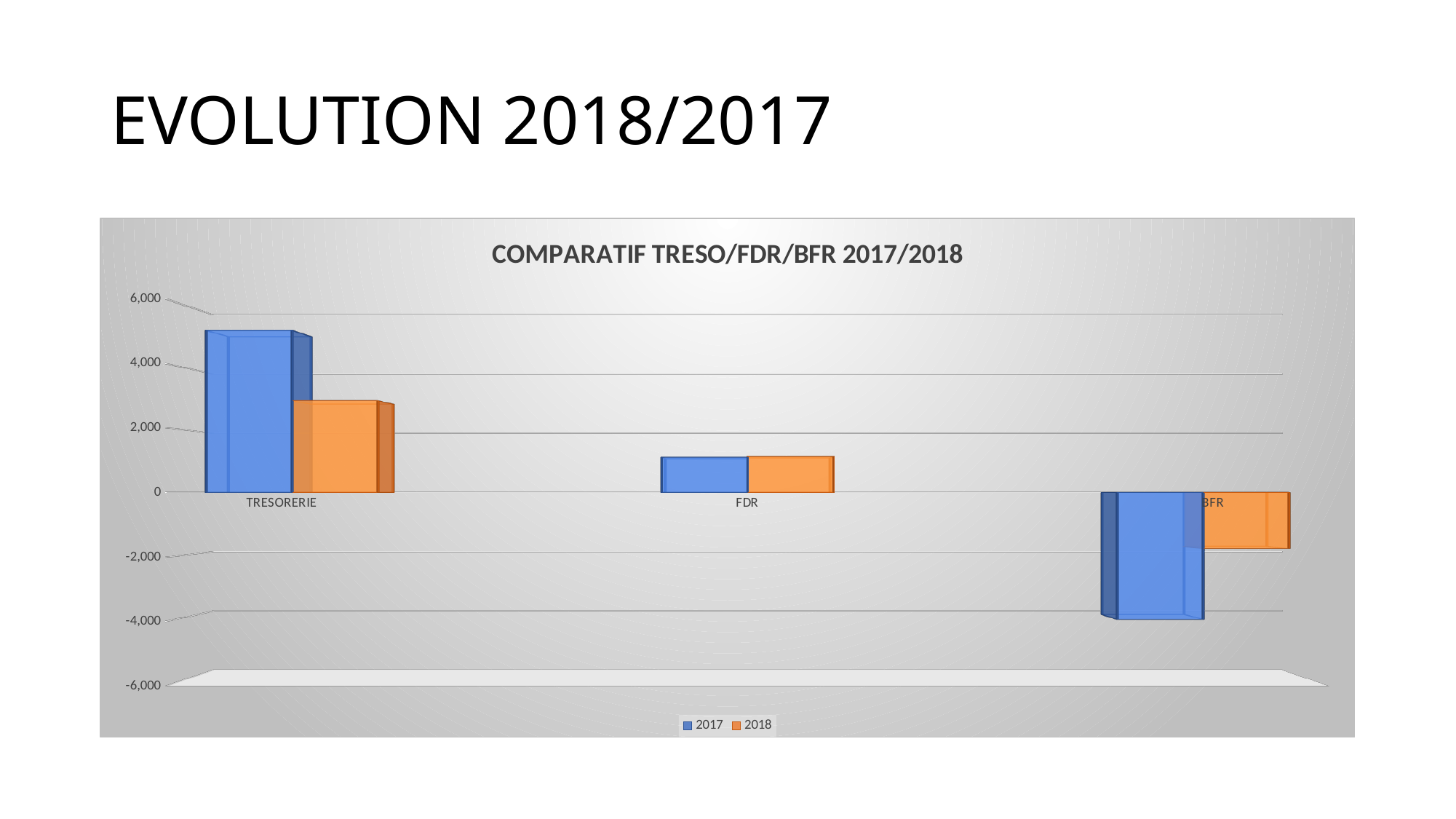
Which category has the lowest value for the 2018 series? BFR What kind of chart is shown on the slide? bar chart For TRESORERIE, which series has the larger value, 2017 or 2018? 2017 How many series does the legend list? 2 Which colour represents the 2018 series in the legend? orange Is the 2017 value for TRESORERIE greater or less than 4,000? greater Which category has the lowest value for the 2017 series? BFR Which category has the highest value for the 2017 series? TRESORERIE Is the 2017 value for FDR greater or less than 2,000? less What is the title of the chart? COMPARATIF TRESO/FDR/BFR 2017/2018 How many categories are shown on the x axis? 3 Is the 2017 value for BFR greater or less than -2,000? less